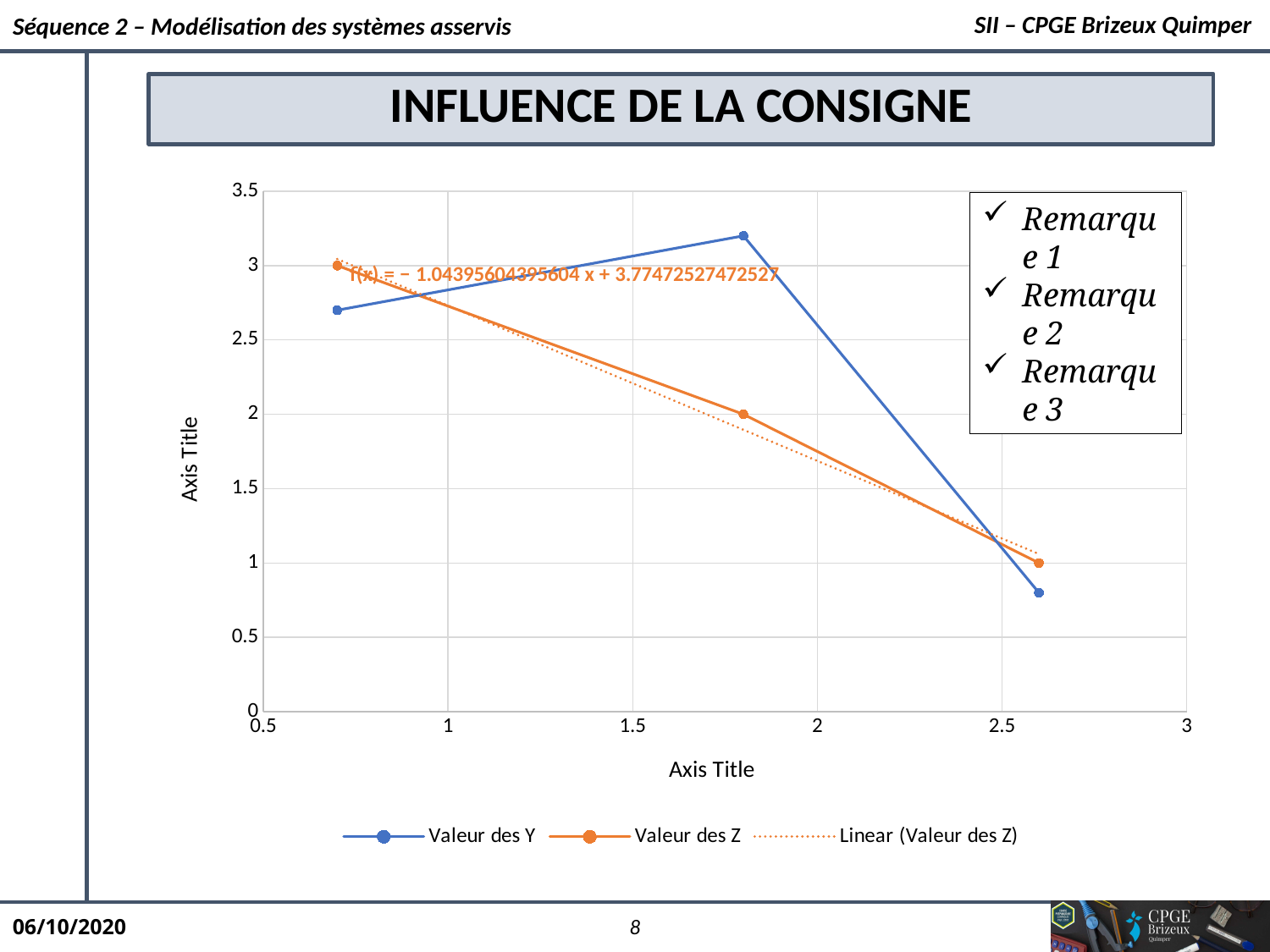
Is the last (rightmost) value of the 'Valeur des Y' series greater or less than 1? less How many data points does the 'Valeur des Y' series have? 3 How many series does the chart legend list? 3 Which series is drawn with a dotted line in the chart? Linear (Valeur des Z) At the middle x position (around 1.8), which series has the larger value, 'Valeur des Y' or 'Valeur des Z'? Valeur des Y What is the trendline equation printed on the chart? f(x) = − 1.04395604395604 x + 3.77472527472527 At the rightmost x position, which series has the larger value, 'Valeur des Y' or 'Valeur des Z'? Valeur des Z What colour is the 'Valeur des Y' series line? blue What kind of chart is shown on the slide? line chart Is the highest value of the 'Valeur des Y' series greater or less than 3? greater Do the values of the 'Valeur des Z' series rise or fall as x increases? fall Is the first (leftmost) value of the 'Valeur des Y' series greater or less than 2.5? greater